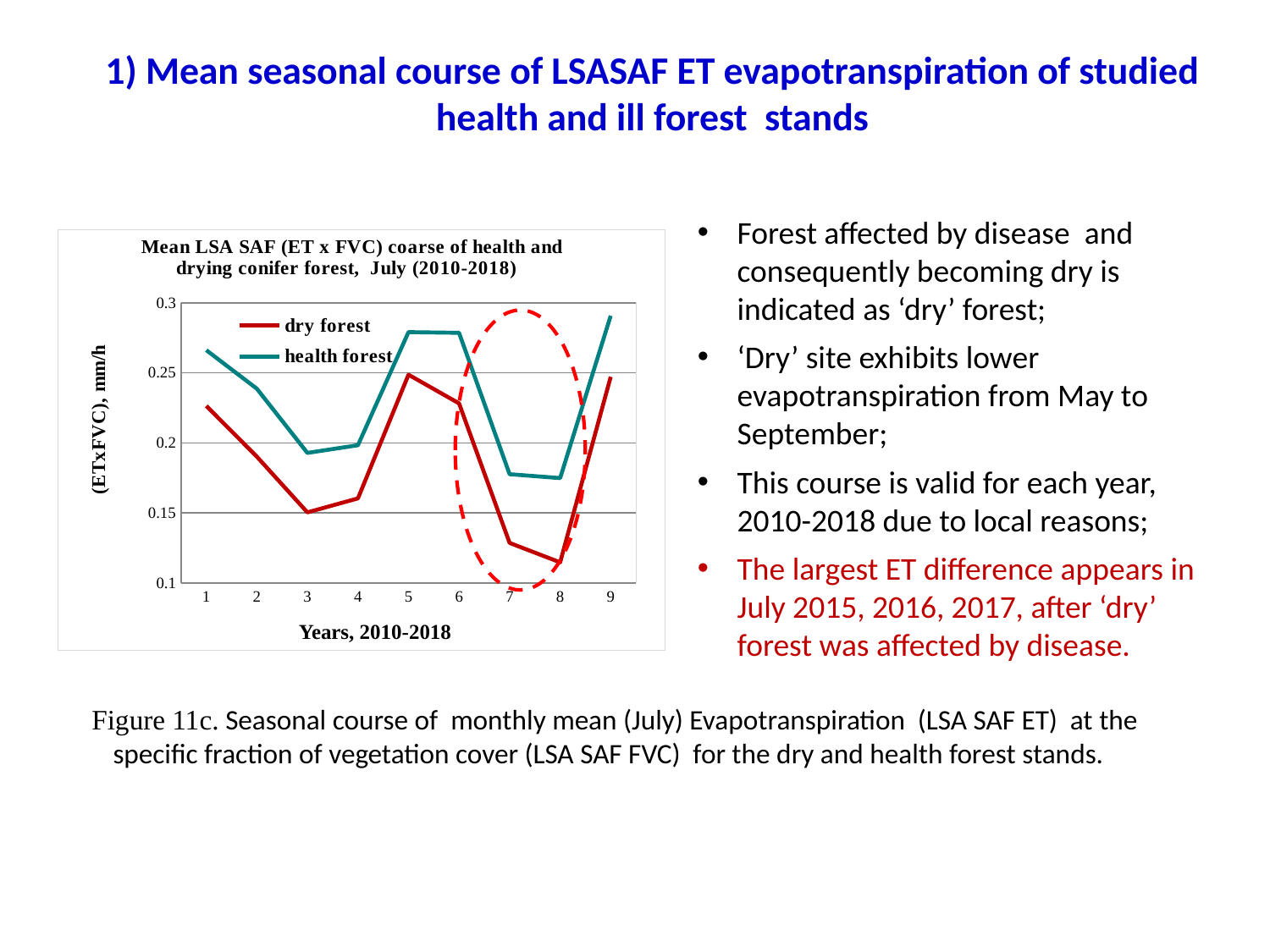
At x = 7, which series has the higher value, dry forest or health forest? health forest Is the value for dry forest at x = 8 greater or less than 0.15? less How many series does the chart legend list? 2 At x = 2, which series has the higher value, dry forest or health forest? health forest Does the dry forest series rise or fall from x = 5 to x = 8? fall Is the value for health forest at x = 5 greater or less than 0.25? greater What colour is the dry forest line in the chart? red Is the value for health forest at x = 1 greater or less than 0.25? greater What kind of chart is shown on the slide? line chart How many points are plotted along the x axis for each series? 9 At which x value does the dry forest series reach its lowest point? 8